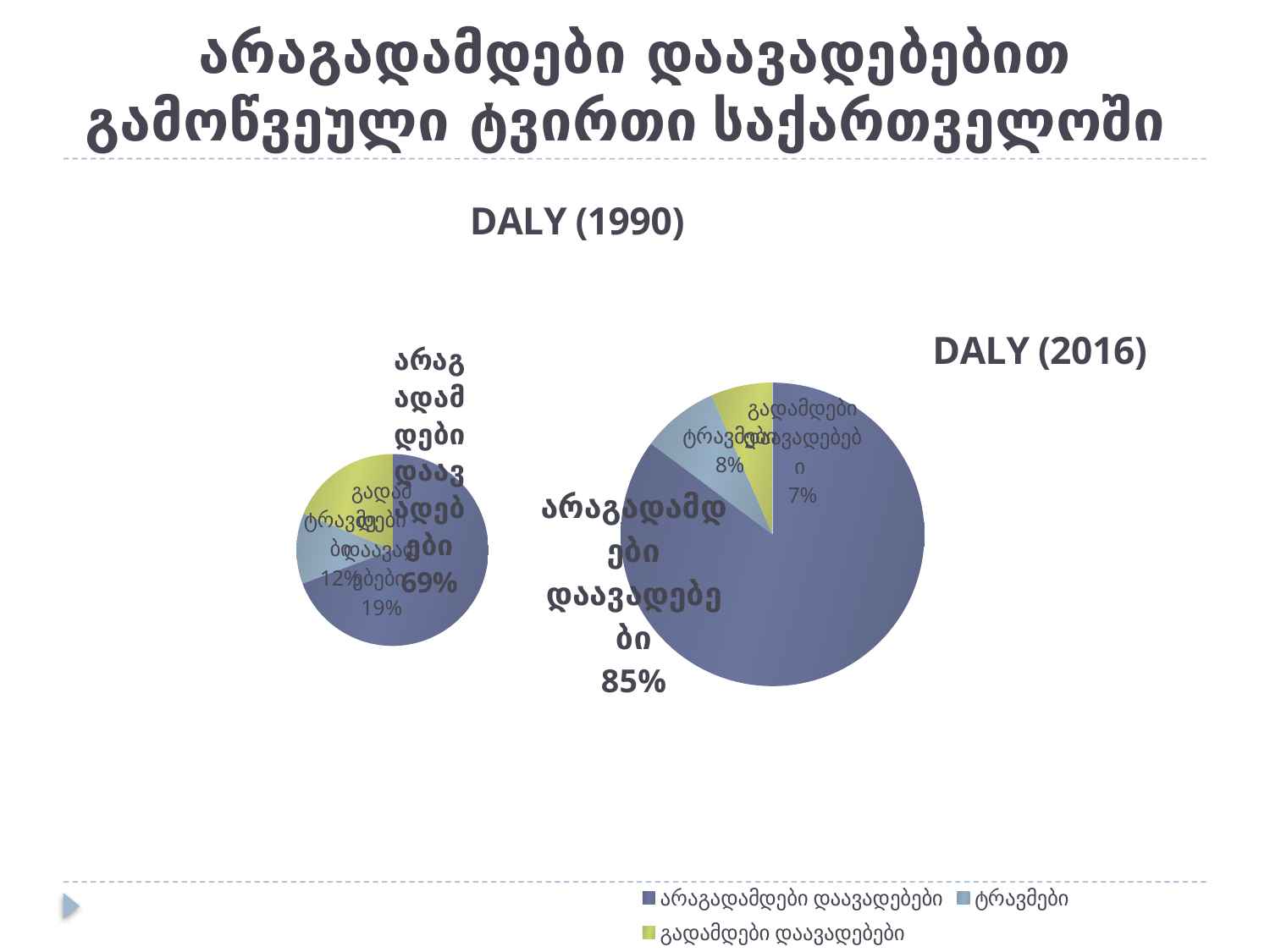
In the DALY (2016) chart, what share is shown for ტრავმები? 8% How many categories does the legend at the bottom of the slide list? 3 In the DALY (1990) chart, what share is shown for გადამდები დაავადებები? 19% In the DALY (1990) chart, which category has the smallest slice? ტრავმები In the DALY (1990) chart, what share is shown for ტრავმები? 12% In the DALY (2016) chart, what share is shown for არაგადამდები დაავადებები? 85% In the DALY (1990) chart, which is larger: the share of გადამდები დაავადებები or the share of ტრავმები? გადამდები დაავადებები In the DALY (2016) chart, which category has the largest slice? არაგადამდები დაავადებები In the DALY (1990) chart, what share is shown for არაგადამდები დაავადებები? 69% What is the difference between the share of არაგადამდები დაავადებები in the DALY (2016) chart and in the DALY (1990) chart? 16% What type of chart is the DALY (2016) chart? Pie chart In the DALY (2016) chart, what share is shown for გადამდები დაავადებები? 7%